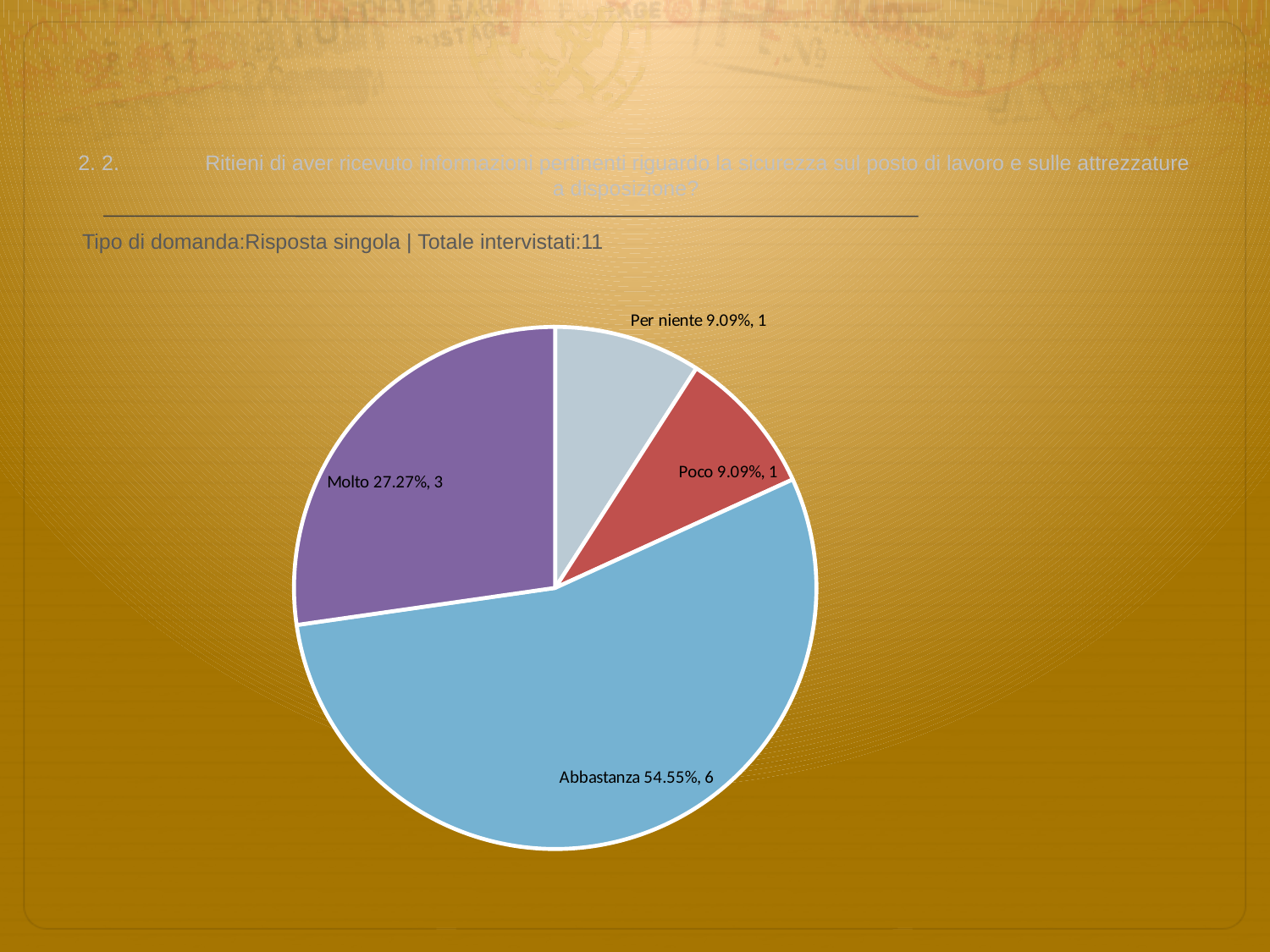
How many respondents answered Abbastanza? 6 What is the difference in respondent count between Abbastanza and Molto? 3 How many respondents answered Poco? 1 Which is larger, the Molto slice or the Per niente slice? Molto What is the total number of respondents shown across all slices? 11 What percentage share does the Molto slice have? 27.27% How many slices does the pie chart have? 4 What kind of chart is shown on the slide? pie chart How many respondents answered Molto? 3 What percentage share does the Abbastanza slice have? 54.55% What colour is the Abbastanza slice? blue Which category has the largest slice? Abbastanza